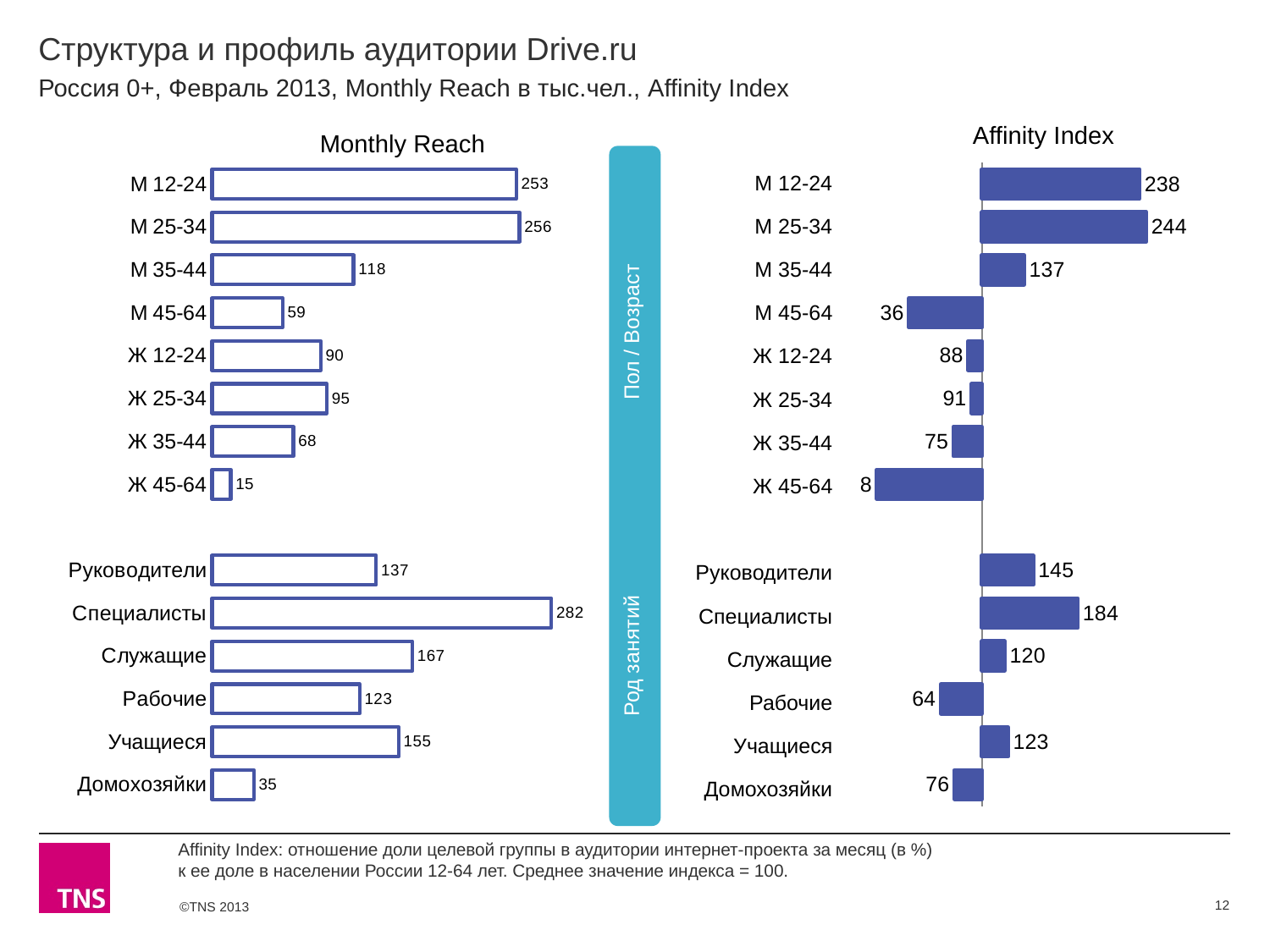
In the Monthly Reach chart, what is the value for Домохозяйки? 35 In the Affinity Index chart, what is the difference between Специалисты and Руководители? 39 In the Monthly Reach chart, which category has the highest value? Специалисты In the Monthly Reach chart, which is larger: Рабочие or Учащиеся? Учащиеся What type of chart is the Affinity Index chart? Bar chart In the Monthly Reach chart, what is the value for М 25-34? 256 How many categories are plotted in the Monthly Reach chart? 14 In the Affinity Index chart, what is the value for Рабочие? 64 In the Affinity Index chart, which is larger: М 12-24 or М 25-34? М 25-34 In the Affinity Index chart, what is the value for Ж 45-64? 8 In the Monthly Reach chart, what is the difference between Специалисты and Служащие? 115 In the Affinity Index chart, which category has the lowest value? Ж 45-64